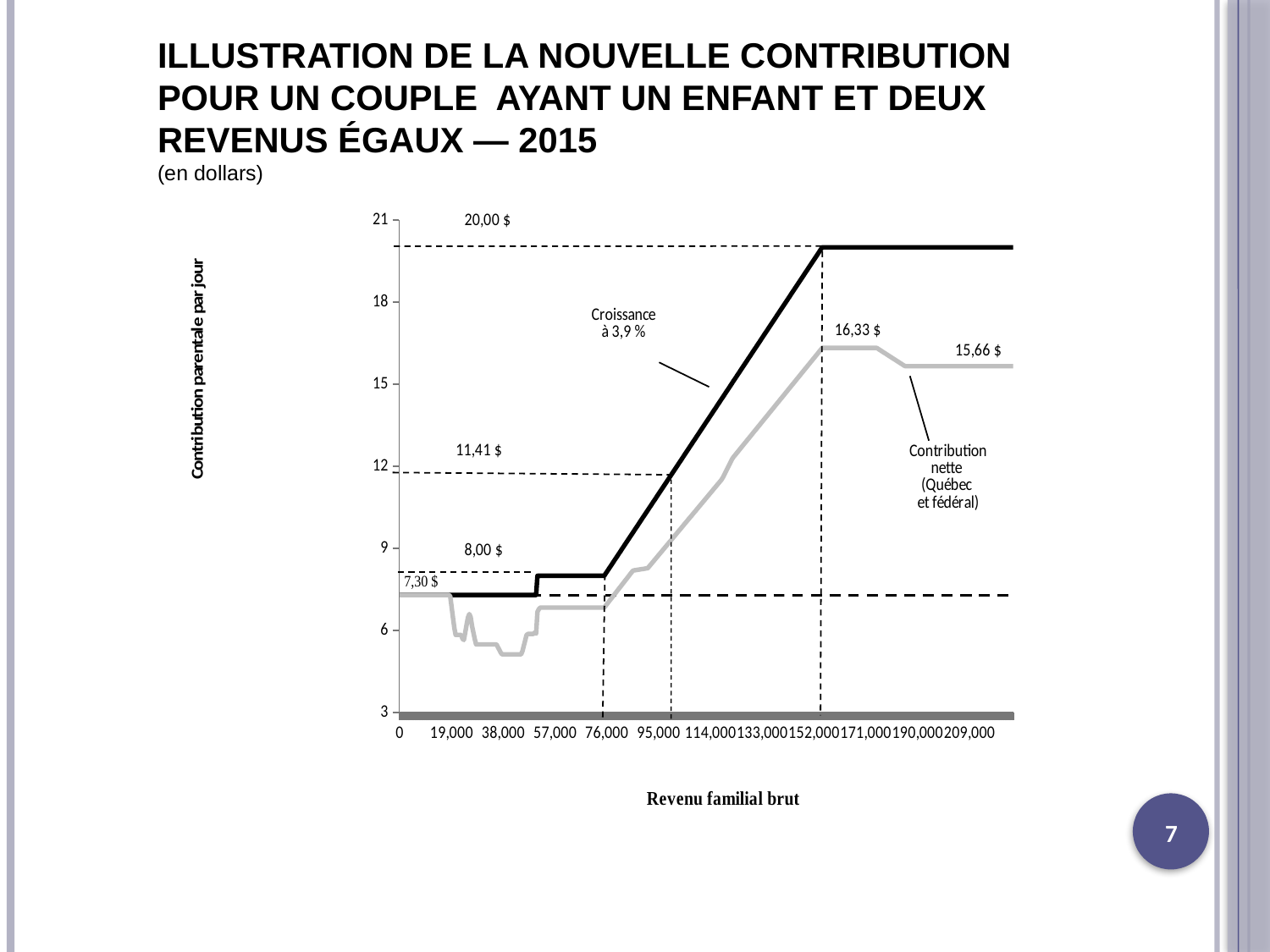
What value is labelled on the black line at a gross family income of 76,000? 8,00 $ What is the value of the black line at a gross family income of 0? 7,30 $ At a gross family income of 209,000, which line is higher, the black line or the grey line? the black line What is the difference between the black line's maximum of 20,00 $ and the grey line's final value of 15,66 $? 4,34 $ What kind of chart is shown on the slide? line chart Is the value of the grey line at a gross family income of 38,000 greater or less than 6? less What is the maximum daily contribution reached by the black line? 20,00 $ What growth rate is annotated on the rising section of the chart? 3,9 % What is the peak value labelled on the net contribution (Québec et fédéral) line? 16,33 $ Does the black line rise or fall between gross family incomes of 76,000 and 152,000? rise What is the value of the net contribution (grey line) at the highest incomes shown, around 209,000? 15,66 $ What is the difference between the 8,00 $ and 7,30 $ levels labelled on the black line? 0,70 $